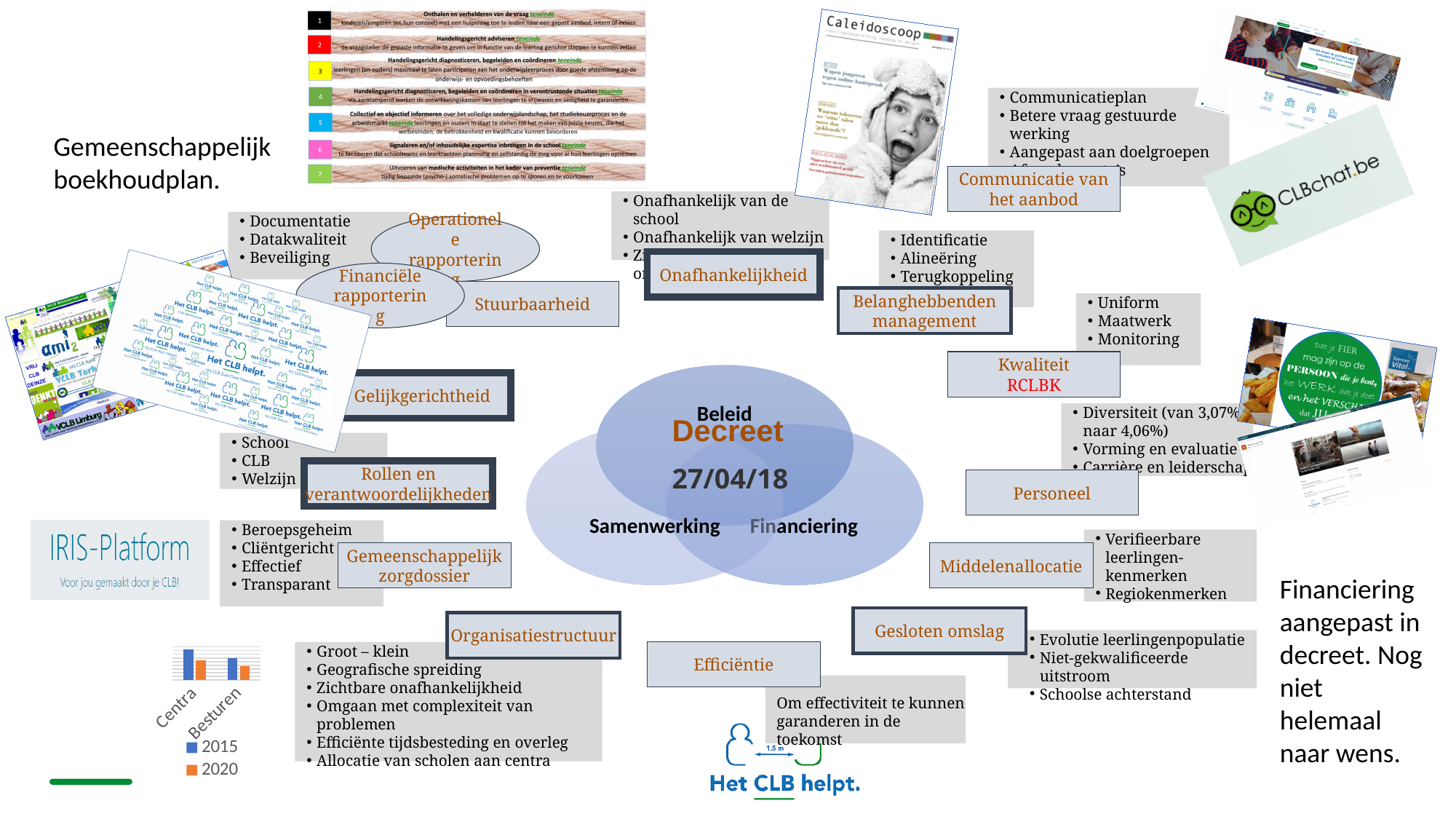
In the bar chart at the bottom left, which category has the higher 2015 value, Centra or Besturen? Centra What are the two categories on the x axis of the bar chart at the bottom left? Centra and Besturen In the bar chart at the bottom left, which category has the tallest bar overall? Centra How many categories does the bar chart at the bottom left show? 2 In the bar chart at the bottom left, which series is larger for Besturen, 2015 or 2020? 2015 Which years are listed in the legend of the bar chart at the bottom left? 2015 and 2020 How many series does the legend of the bar chart at the bottom left list? 2 What kind of chart is shown at the bottom left of the slide? bar chart In the bar chart at the bottom left, do the values for Centra rise or fall from 2015 to 2020? fall In the bar chart at the bottom left, which series is larger for Centra, 2015 or 2020? 2015 In the bar chart at the bottom left, do the values for Besturen rise or fall from 2015 to 2020? fall